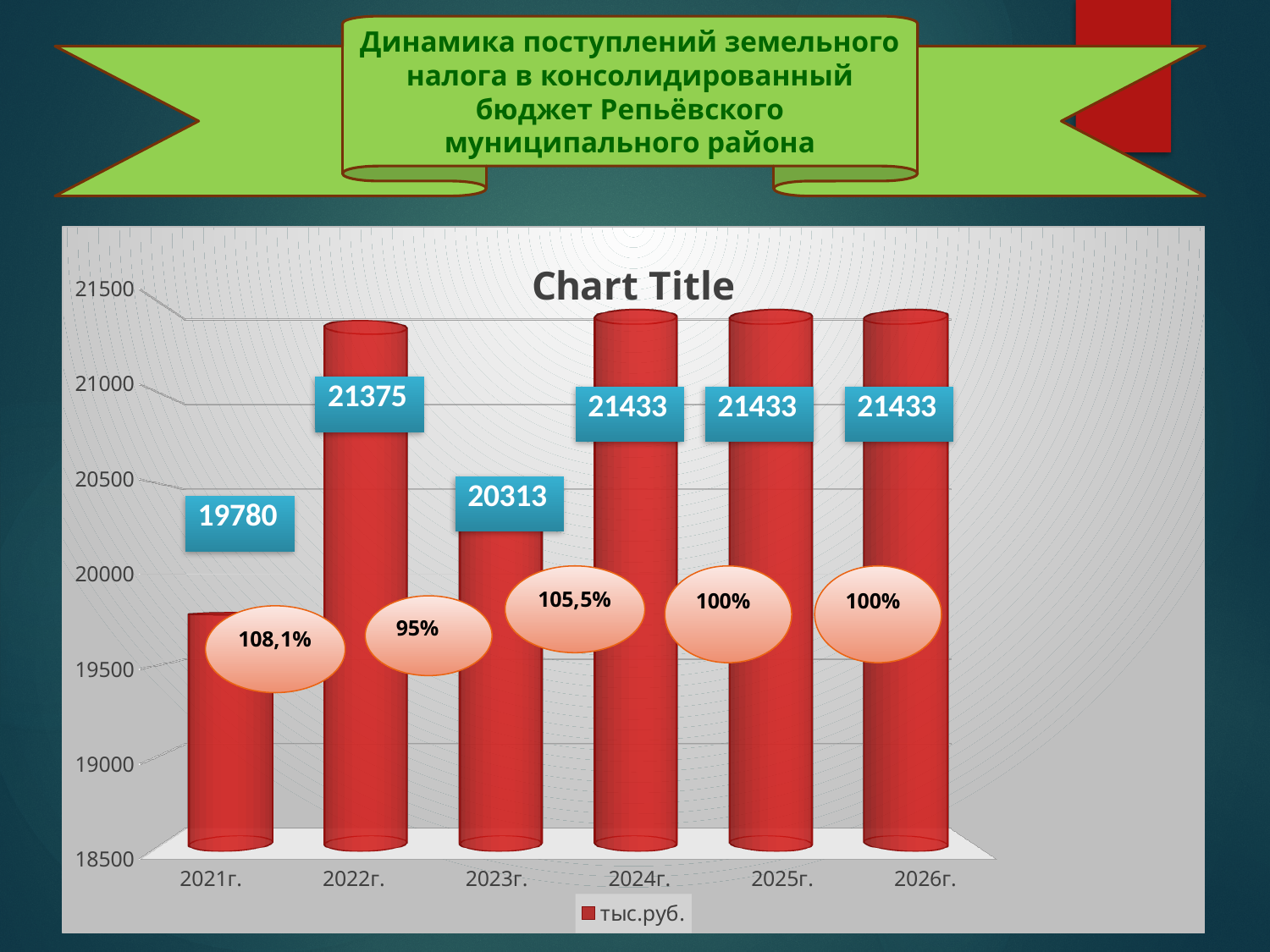
What is the value for 2023г.? 20313 How many series does the legend list? 1 What is the legend entry of the chart? тыс.руб. What kind of chart is shown? bar chart What is the value for 2025г.? 21433 What is the difference between the values for 2022г. and 2021г.? 1595 Which is larger, the value for 2022г. or the value for 2023г.? 2022г. What is the difference between the values for 2024г. and 2023г.? 1120 How many years are shown on the x axis? 6 Is the value for 2021г. greater or less than 20000? less Which year has the lowest value? 2021г. What is the value for 2021г.? 19780